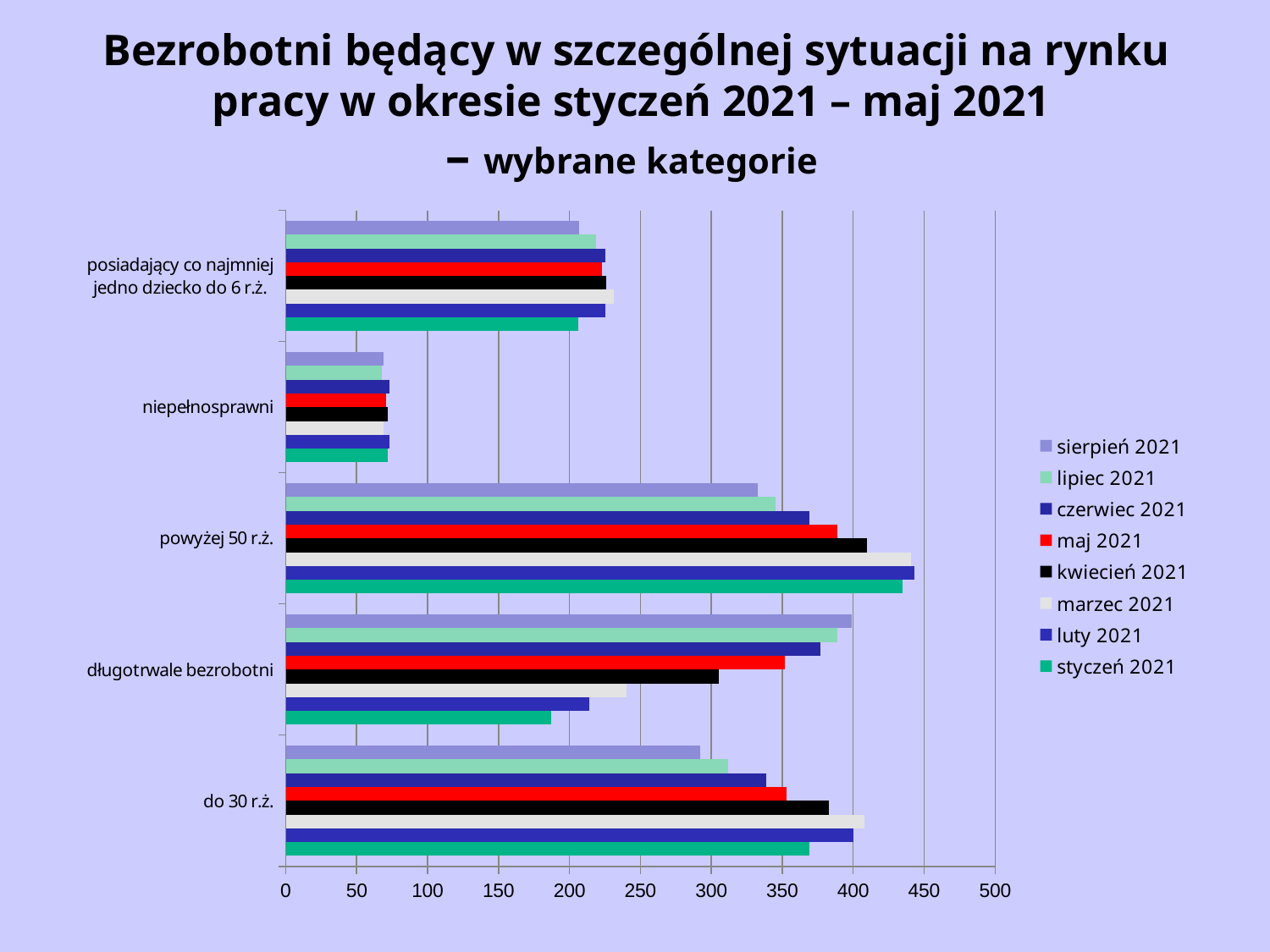
In the category powyżej 50 r.ż., which is larger: the value for luty 2021 or for sierpień 2021? luty 2021 Which colour represents maj 2021 in the legend? red Which category has the highest bar in the chart? powyżej 50 r.ż. Is the value for kwiecień 2021 in the category powyżej 50 r.ż. greater or less than 400? greater Which category has the lowest values across all months? niepełnosprawni Is the value for czerwiec 2021 in the category długotrwale bezrobotni greater or less than 350? greater What kind of chart is shown on the slide? bar chart In the category długotrwale bezrobotni, which is larger: the value for sierpień 2021 or for styczeń 2021? sierpień 2021 How many series does the legend list? 8 Is the value for styczeń 2021 in the category długotrwale bezrobotni greater or less than 200? less How many categories are shown on the vertical axis of the chart? 5